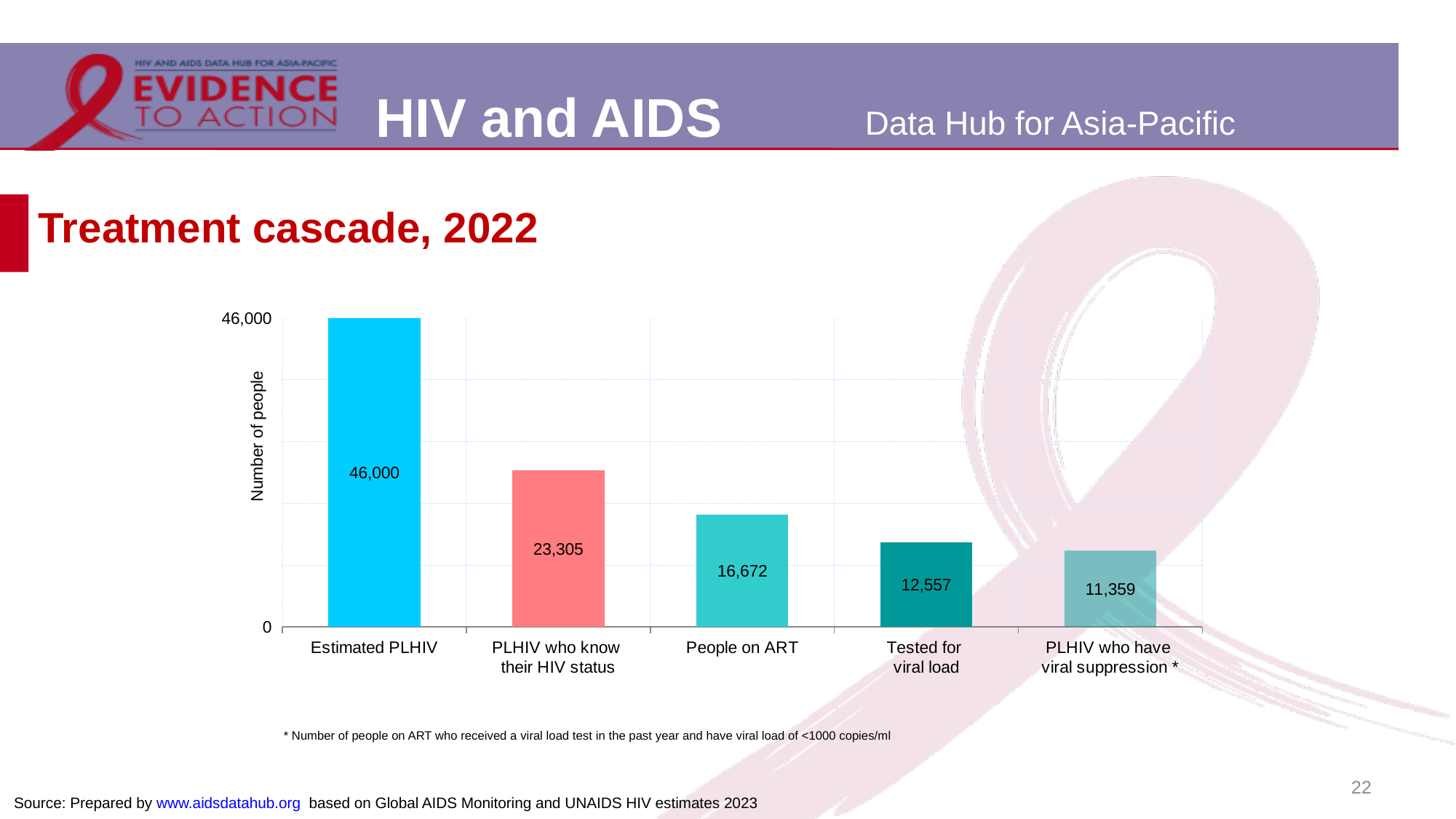
What is the value for Tested for viral load? 12,557 Which category has the highest value? Estimated PLHIV What is the value for Estimated PLHIV? 46,000 Which category has the lowest value? PLHIV who have viral suppression How many categories are shown in the chart? 5 What kind of chart is shown on the slide? Bar chart What is the value for PLHIV who know their HIV status? 23,305 What is the value for People on ART? 16,672 What is the value for PLHIV who have viral suppression? 11,359 What is the difference between Estimated PLHIV and PLHIV who know their HIV status? 22,695 What is the difference between People on ART and Tested for viral load? 4,115 Which is larger, the value for People on ART or the value for Tested for viral load? People on ART